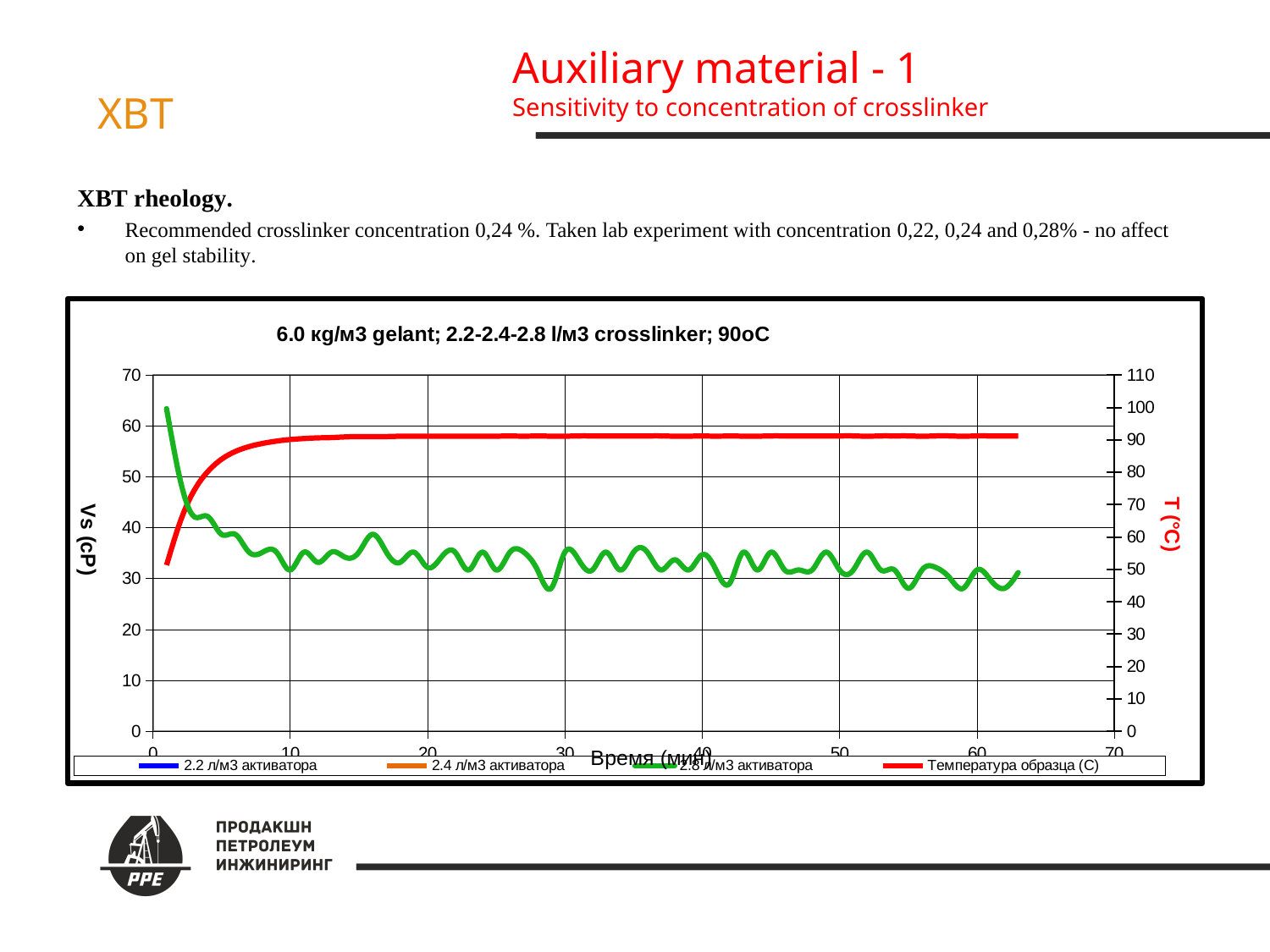
How many series does the chart legend list? 4 Is the value of the '2.8 л/м3 активатора' line at 20 minutes greater or less than 20 cP? greater Is the value of the '2.8 л/м3 активатора' line at 40 minutes greater or less than 50 cP? less What kind of chart is shown on the slide? line chart What is the label of the left vertical axis of the chart? Vs (cP) What is the title of the chart? 6.0 кg/м3 gelant; 2.2-2.4-2.8 l/м3 crosslinker; 90oC Does the red 'Температура образца (С)' line rise or fall during the first 10 minutes? rise What is the maximum value shown on the right vertical axis (T (°C)) of the chart? 110 Is the value of the 'Температура образца (С)' line at 60 minutes greater or less than 80 °C? greater Does the green '2.8 л/м3 активатора' line rise or fall overall as time increases along the x axis? fall